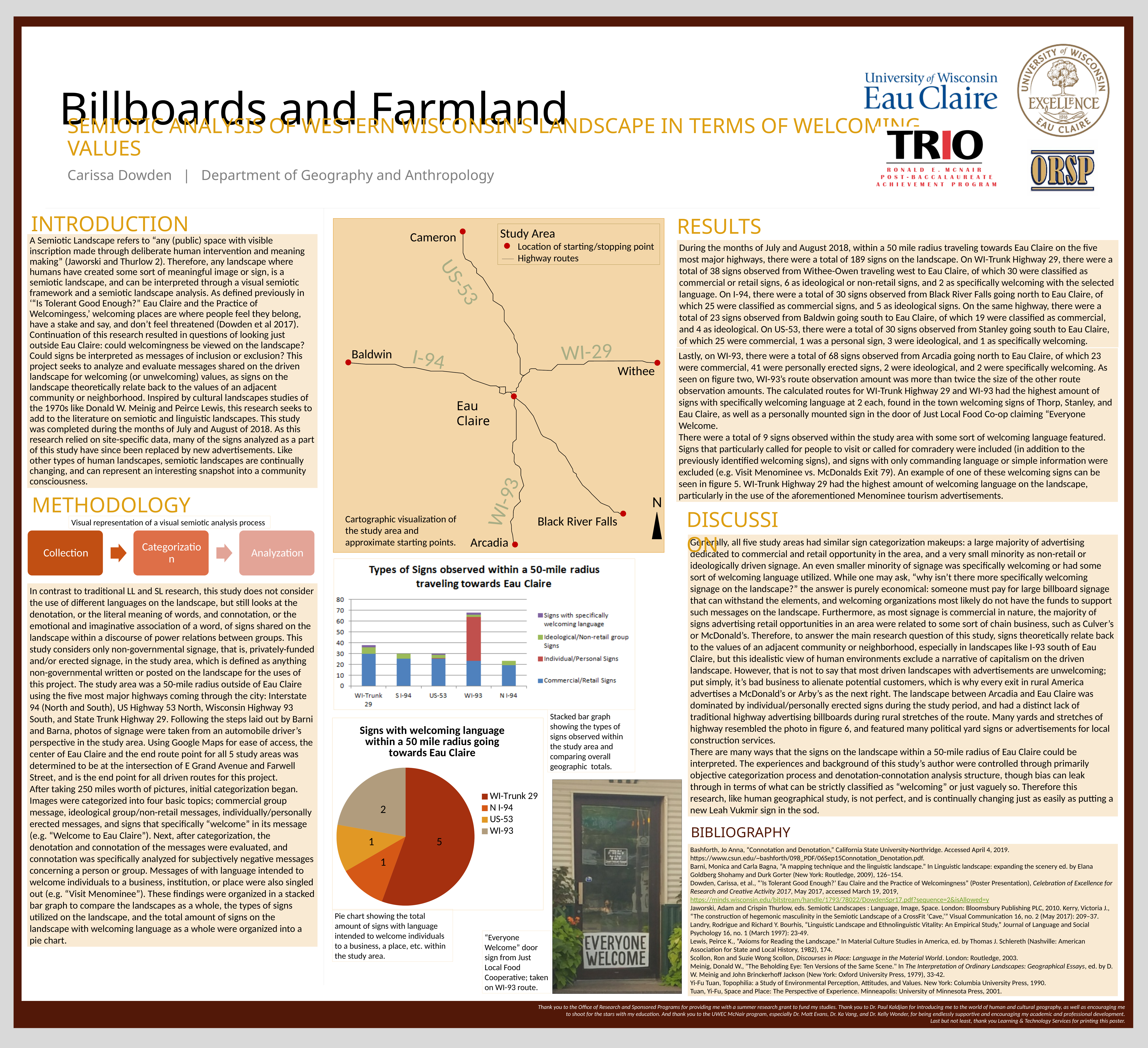
What kind of chart is 'Types of Signs observed within a 50-mile radius traveling towards Eau Claire'? Stacked bar chart In the pie chart 'Signs with welcoming language within a 50 mile radius going towards Eau Claire', which route has the largest slice? WI-Trunk 29 In the pie chart 'Signs with welcoming language within a 50 mile radius going towards Eau Claire', what is the value for WI-93? 2 In the stacked bar chart 'Types of Signs observed within a 50-mile radius traveling towards Eau Claire', how many routes are shown on the x axis? 5 In the stacked bar chart 'Types of Signs observed within a 50-mile radius traveling towards Eau Claire', which sign type is shown in red? Individual/Personal Signs In the stacked bar chart 'Types of Signs observed within a 50-mile radius traveling towards Eau Claire', which route has the tallest bar? WI-93 In the pie chart 'Signs with welcoming language within a 50 mile radius going towards Eau Claire', what is the total of all the slice values? 9 In the stacked bar chart 'Types of Signs observed within a 50-mile radius traveling towards Eau Claire', how many sign types does the legend list? 4 In the pie chart 'Signs with welcoming language within a 50 mile radius going towards Eau Claire', what is the difference between the values for WI-Trunk 29 and WI-93? 3 In the pie chart 'Signs with welcoming language within a 50 mile radius going towards Eau Claire', how many routes does the legend list? 4 In the pie chart 'Signs with welcoming language within a 50 mile radius going towards Eau Claire', what is the value for WI-Trunk 29? 5 In the stacked bar chart 'Types of Signs observed within a 50-mile radius traveling towards Eau Claire', is the total for WI-93 greater or less than 60? greater